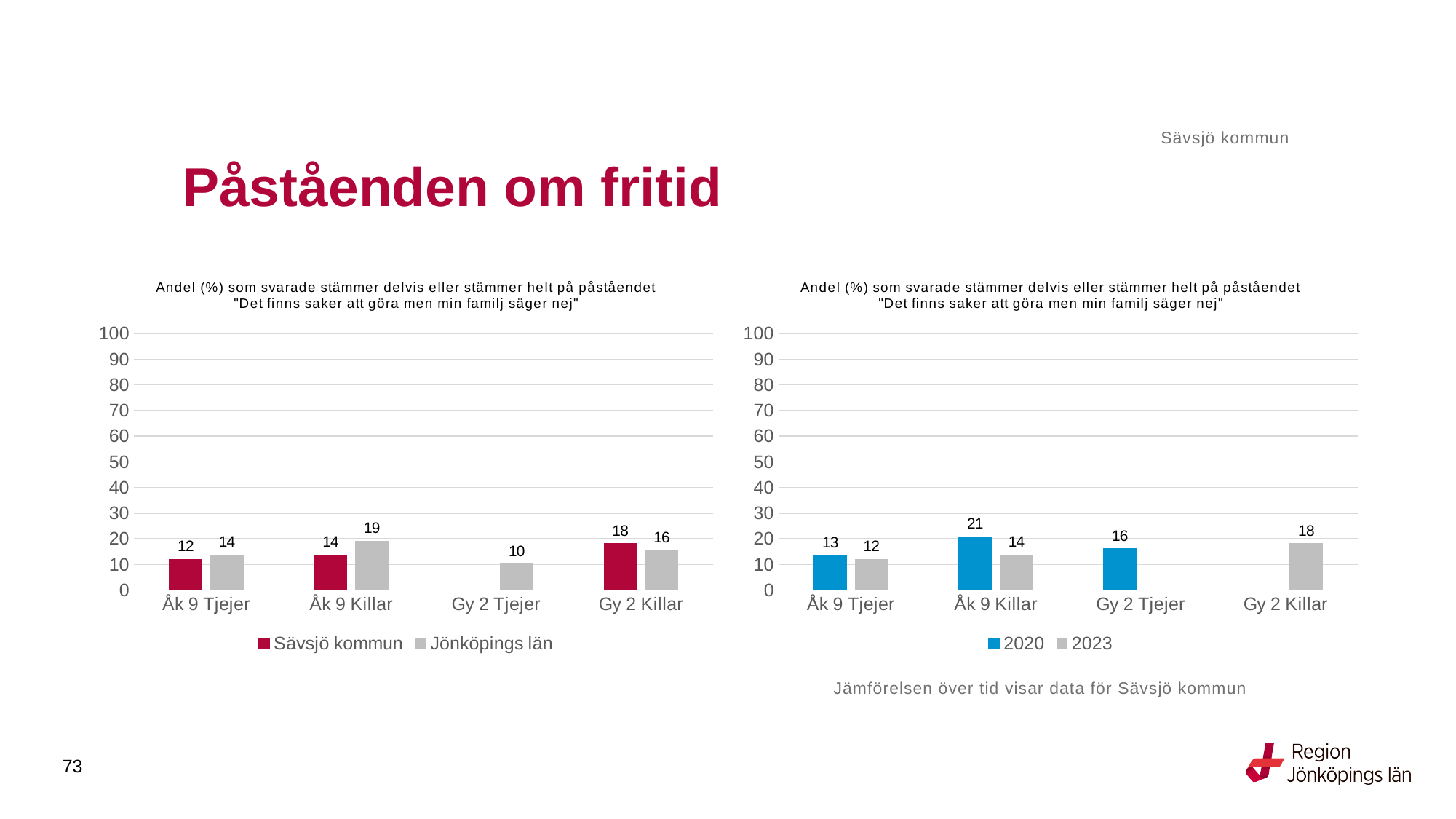
In the right chart, what is the value for 2023 for Gy 2 Killar? 18 In the left chart, which is larger for Gy 2 Killar: Sävsjö kommun or Jönköpings län? Sävsjö kommun How many series does the legend of the left chart list? 2 How many categories are shown on the x axis of the right chart? 4 In the left chart, what is the difference between Jönköpings län and Sävsjö kommun for Åk 9 Killar? 5 In the left chart, which category has the highest value for Jönköpings län? Åk 9 Killar In the right chart, which category has the lowest value for 2023? Åk 9 Tjejer In the left chart, what is the value for Jönköpings län for Gy 2 Tjejer? 10 In the left chart, what is the value for Sävsjö kommun for Åk 9 Killar? 14 In the right chart, what is the difference between 2020 and 2023 for Åk 9 Killar? 7 In the right chart, what is the value for 2020 for Åk 9 Killar? 21 What type of chart is the right chart? Bar chart